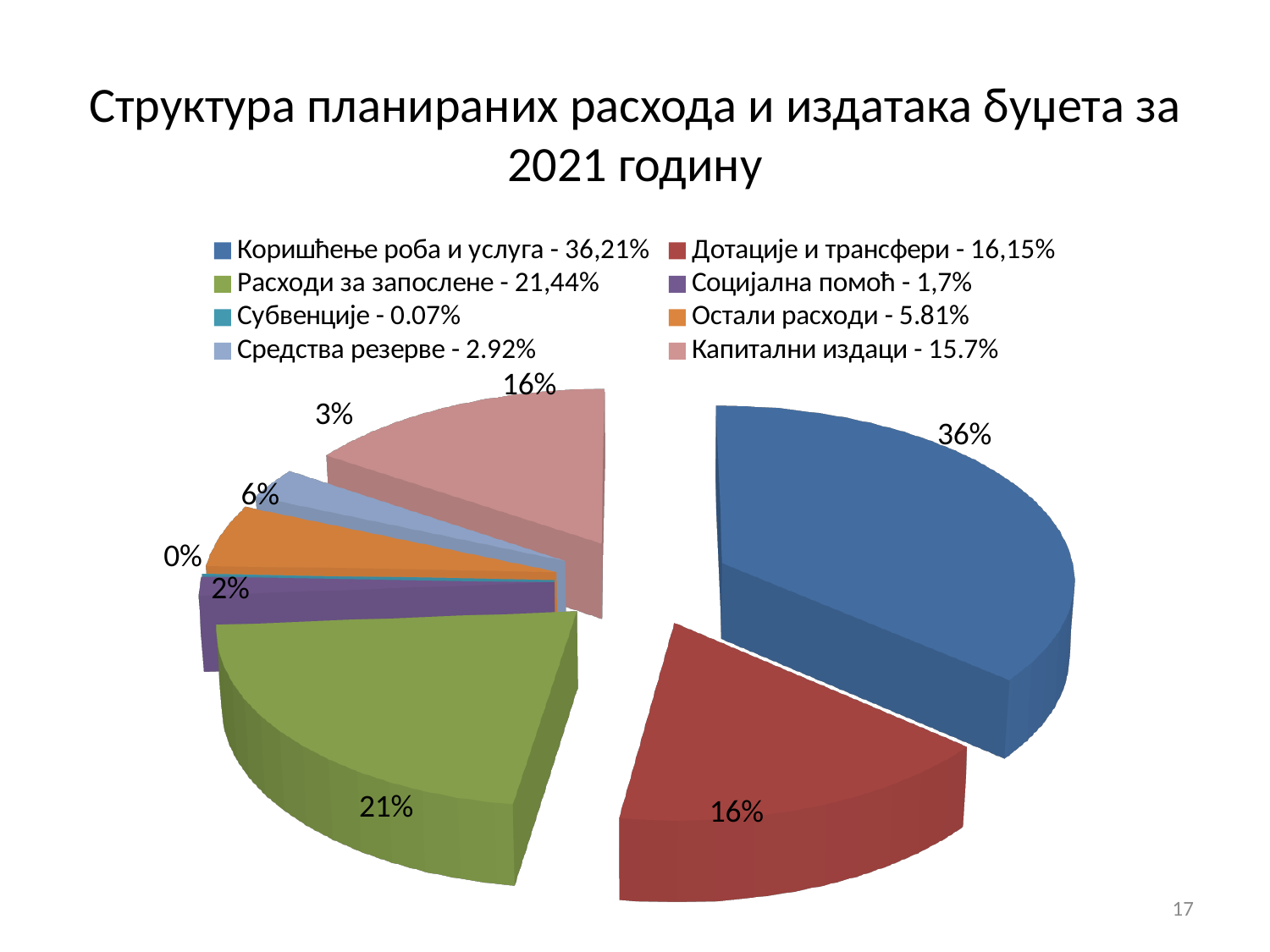
According to the legend, what is the exact share for Капитални издаци? 15.7% What percentage label is shown on the slice for Коришћење роба и услуга? 36% What percentage label is shown on the slice for Субвенције? 0% Which slice is larger: Расходи за запослене or Дотације и трансфери? Расходи за запослене How many entries does the legend list? 8 Which category has the largest slice of the pie? Коришћење роба и услуга How many slices does the pie chart have? 8 Which category has the smallest slice of the pie? Субвенције What kind of chart is shown on the slide? Pie chart What percentage label is shown on the slice for Остали расходи? 6% What percentage label is shown on the slice for Расходи за запослене? 21% What is the difference in percentage points between the data labels for Коришћење роба и услуга (36%) and Расходи за запослене (21%)? 15